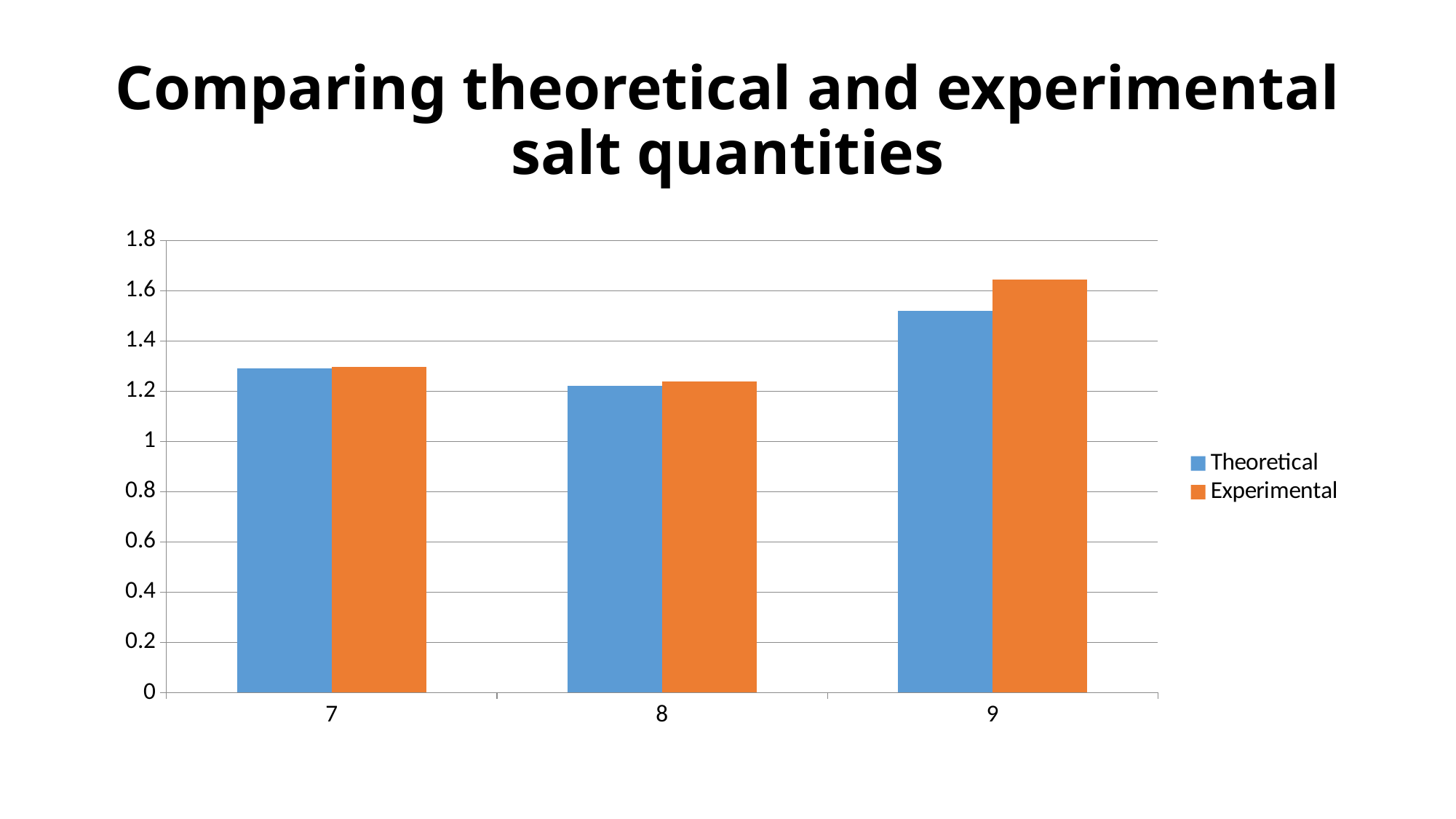
Which category has the highest Theoretical value? 9 How many categories are shown on the x axis? 3 Is the Theoretical value for category 8 greater or less than 1.2? greater Is the Experimental value for category 9 greater or less than 1.6? greater For category 9, which is larger: the Theoretical or the Experimental value? Experimental How many series does the legend list? 2 What kind of chart is shown on the slide? bar chart Which category has the lowest Experimental value? 8 Which is larger: the Theoretical value for category 7 or the Theoretical value for category 8? category 7 What is the title of the chart? Comparing theoretical and experimental salt quantities Is the Theoretical value for category 9 greater or less than 1.6? less